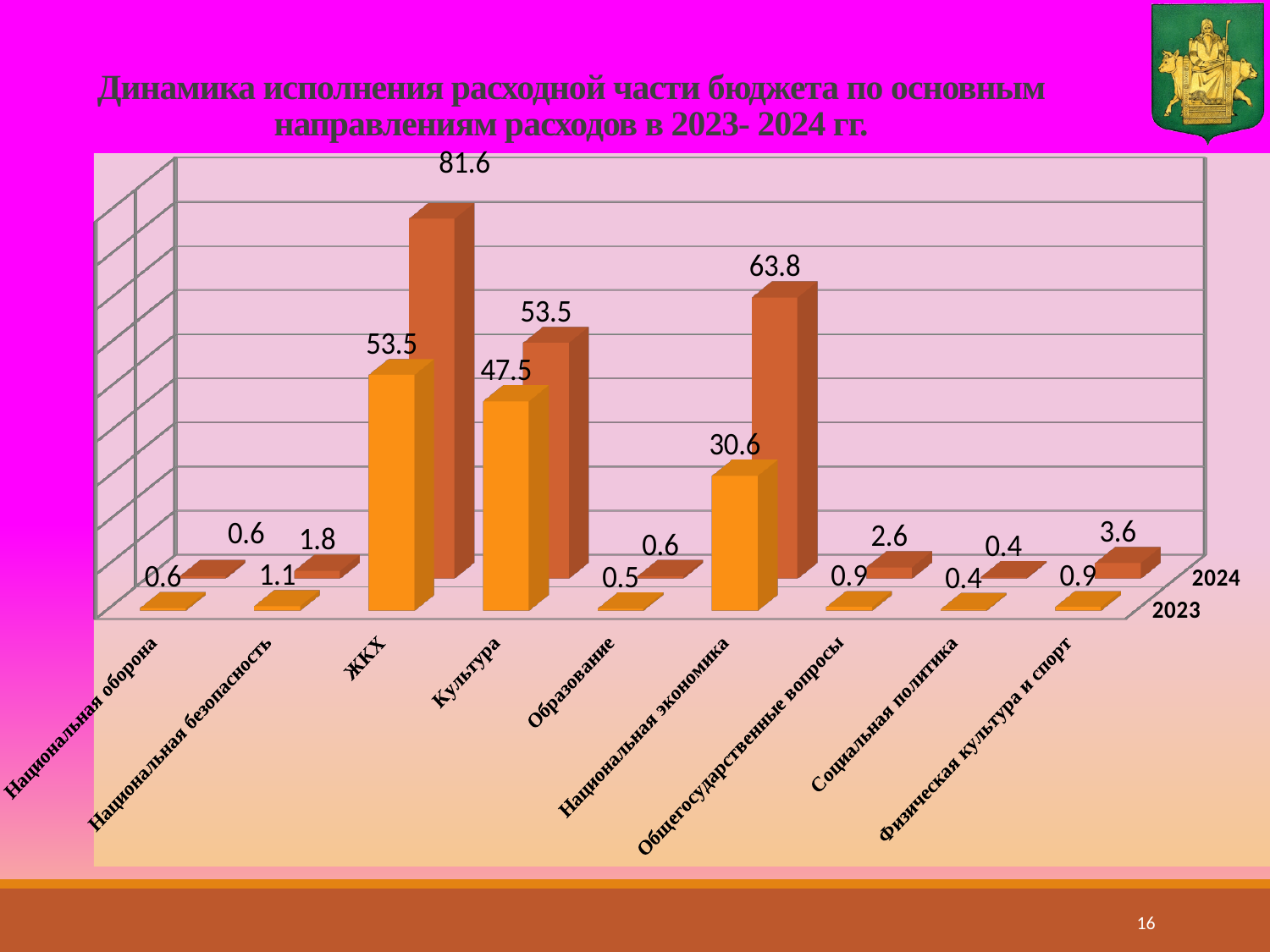
How many years (series) are plotted in the chart? 2 What is the difference between the 2024 and 2023 values for Национальная экономика? 33.2 What is the value for Культура in 2023? 47.5 What type of chart is shown on the slide? Bar chart What is the difference between the 2024 and 2023 values for ЖКХ? 28.1 Which category has the highest value in 2024? ЖКХ Which is larger: the 2023 value for ЖКХ or the 2023 value for Культура? ЖКХ How many expenditure categories are shown on the x axis? 9 What is the value for Физическая культура и спорт in 2024? 3.6 What is the value for ЖКХ in 2024? 81.6 What is the value for Национальная экономика in 2023? 30.6 Which category has the lowest value in 2023? Социальная политика